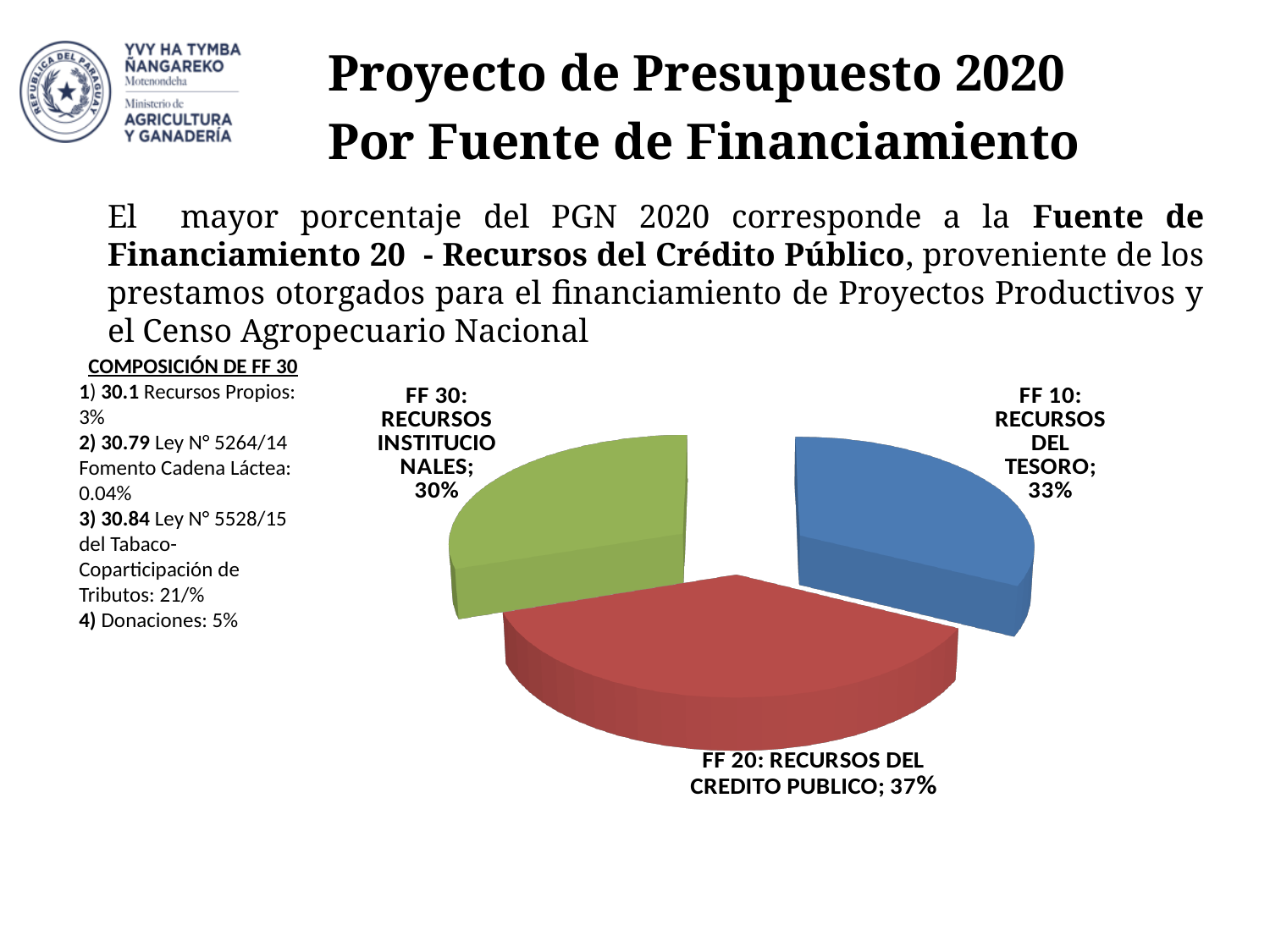
What share of the pie does FF 10: Recursos del Tesoro represent? 33% What is the difference in percentage points between FF 10 and FF 30? 3 Which is larger, the share for FF 10 or the share for FF 20? FF 20 How many slices does the pie chart have? 3 What colour is the slice for FF 20: Recursos del Crédito Público? Red What share of the pie does FF 30: Recursos Institucionales represent? 30% What kind of chart is shown on the slide? Pie chart Which funding source has the largest slice of the pie? FF 20: Recursos del Crédito Público What share of the pie does FF 20: Recursos del Crédito Público represent? 37% What colour is the slice for FF 10: Recursos del Tesoro? Blue What is the difference in percentage points between FF 20 and FF 30? 7 Which funding source has the smallest slice of the pie? FF 30: Recursos Institucionales